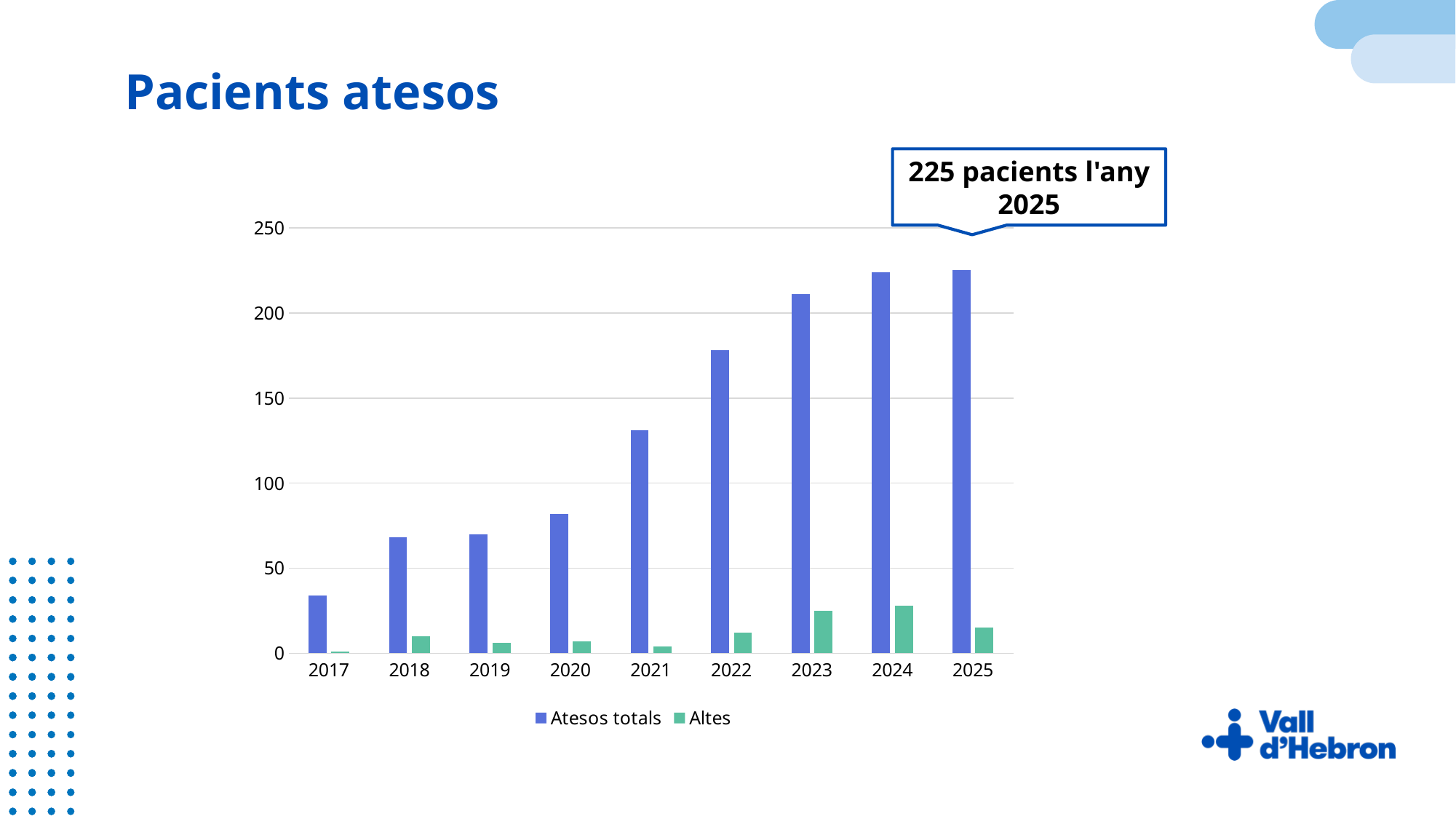
What is the title of the slide's chart? Pacients atesos How many years are shown on the x axis? 9 According to the callout, what is the value of Atesos totals for 2025? 225 Is the value of Atesos totals for 2021 greater or less than 100? greater What kind of chart is shown on the slide? bar chart How many series does the legend list? 2 Is the value of Atesos totals for 2022 greater or less than 200? less Do the values of Atesos totals rise or fall from 2017 to 2025? rise Which is larger, Atesos totals for 2021 or for 2022? 2022 Which year has the lowest value for Altes? 2017 Is the value of Atesos totals for 2017 greater or less than 50? less Which year has the lowest value for Atesos totals? 2017